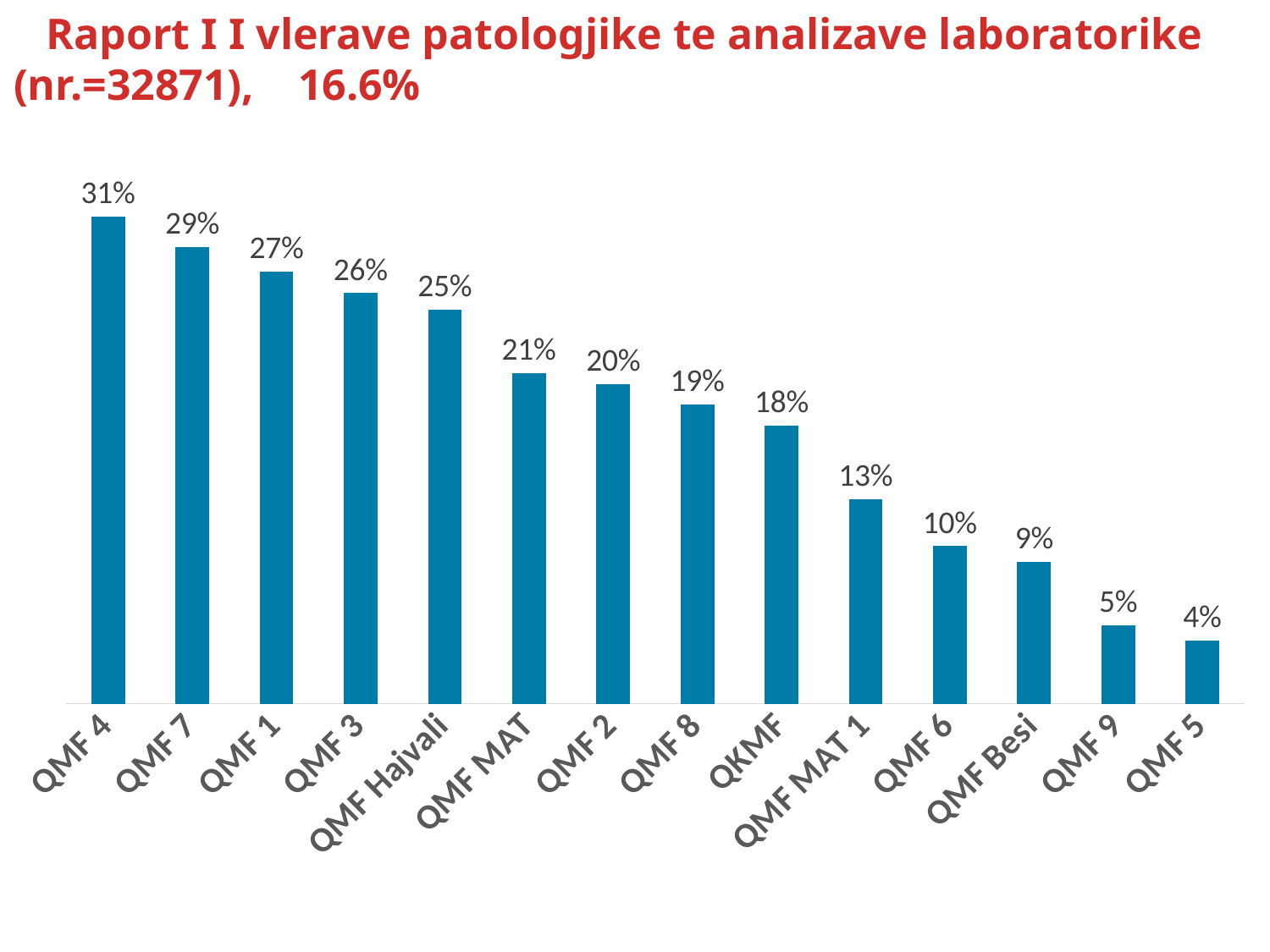
Which is larger, the value for QMF 2 or the value for QMF 6? QMF 2 What is the value for QKMF? 18% Do the values rise or fall from left to right along the x axis? Fall What is the difference between the values for QMF 7 and QMF MAT 1? 16% Which category has the lowest value? QMF 5 What kind of chart is shown on the slide? Bar chart What overall percentage is stated in the chart title? 16.6% What is the value for QMF Hajvali? 25% What is the value for QMF 4? 31% Which category has the highest value? QMF 4 What is the value for QMF Besi? 9% How many categories are shown on the chart? 14